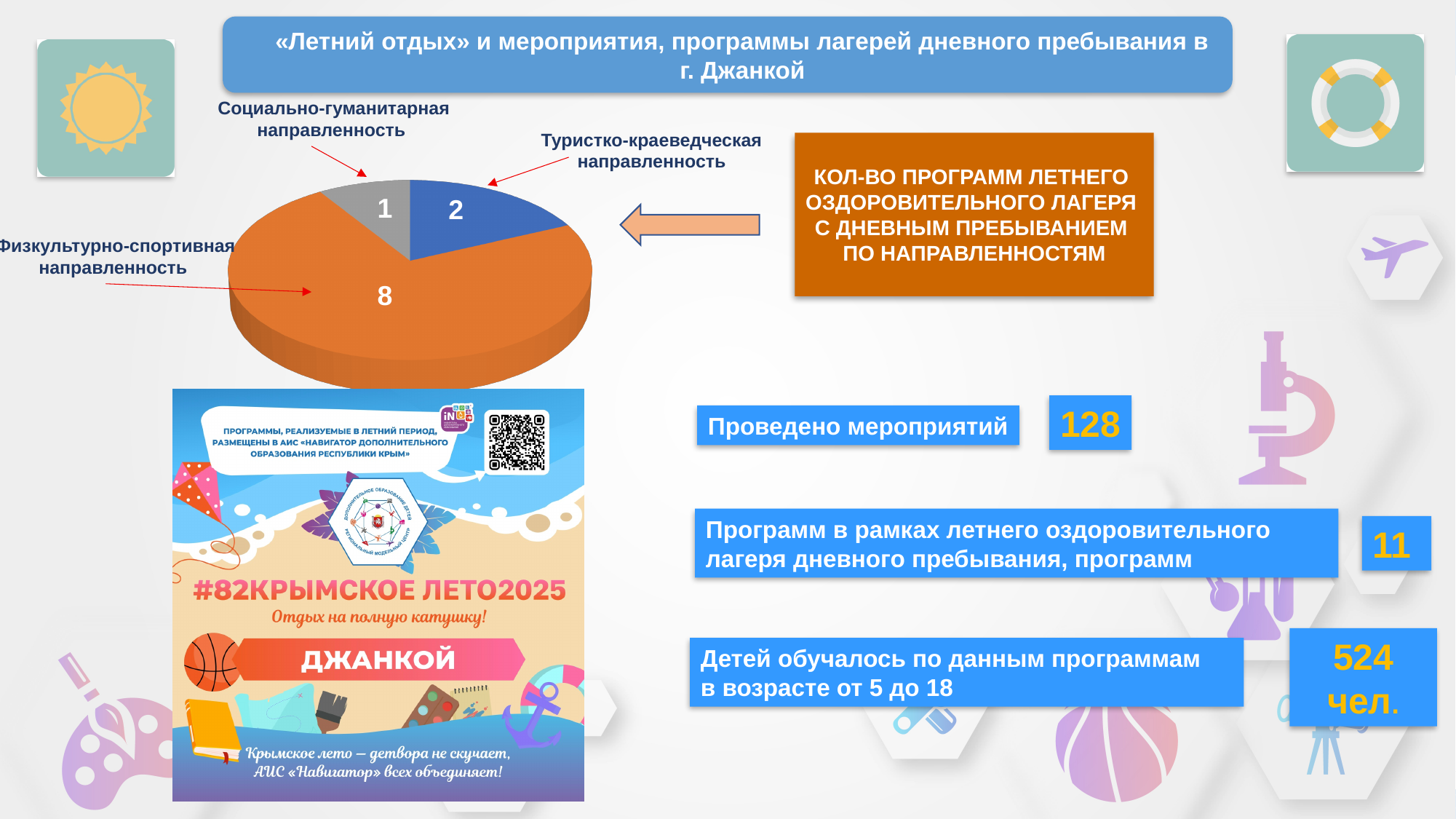
What is the total of all slices in the pie chart? 11 How many slices does the pie chart have? 3 What is the difference between the values for Физкультурно-спортивная направленность and Туристско-краеведческая направленность? 6 What is the value for Социально-гуманитарная направленность in the pie chart? 1 Which category has the largest slice in the pie chart? Физкультурно-спортивная направленность What is the value for Физкультурно-спортивная направленность in the pie chart? 8 Which is larger: the value for Туристско-краеведческая направленность or for Социально-гуманитарная направленность? Туристско-краеведческая направленность Which category has the smallest slice in the pie chart? Социально-гуманитарная направленность What kind of chart is shown on the slide? pie chart What is the value for Туристско-краеведческая направленность in the pie chart? 2 What colour is the slice for Физкультурно-спортивная направленность? orange What fraction of the pie does Физкультурно-спортивная направленность represent? 8/11